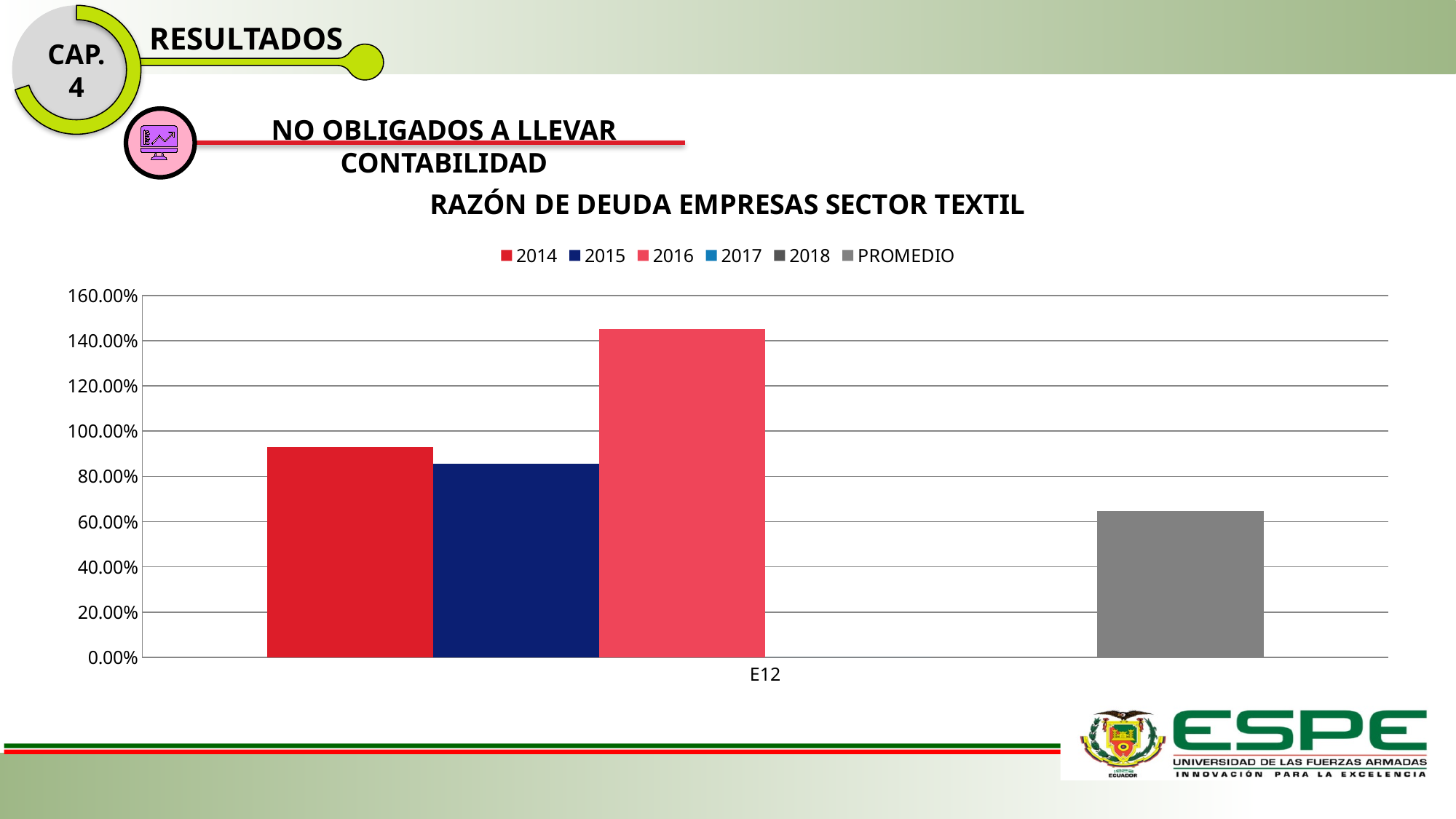
What kind of chart is shown on the slide? bar chart Which is larger for E12, the value for 2014 or the value for 2015? 2014 Is the value for PROMEDIO greater or less than 80.00%? less How many categories are shown on the x axis? 1 Which is larger for E12, the value for 2015 or the value for PROMEDIO? 2015 What is the title of the chart? RAZÓN DE DEUDA EMPRESAS SECTOR TEXTIL Is the value for 2016 greater or less than 120.00%? greater Which series has the tallest bar for E12? 2016 Is the value for 2014 greater or less than 100.00%? less How many series does the legend list? 6 What is the label of the category on the x axis? E12